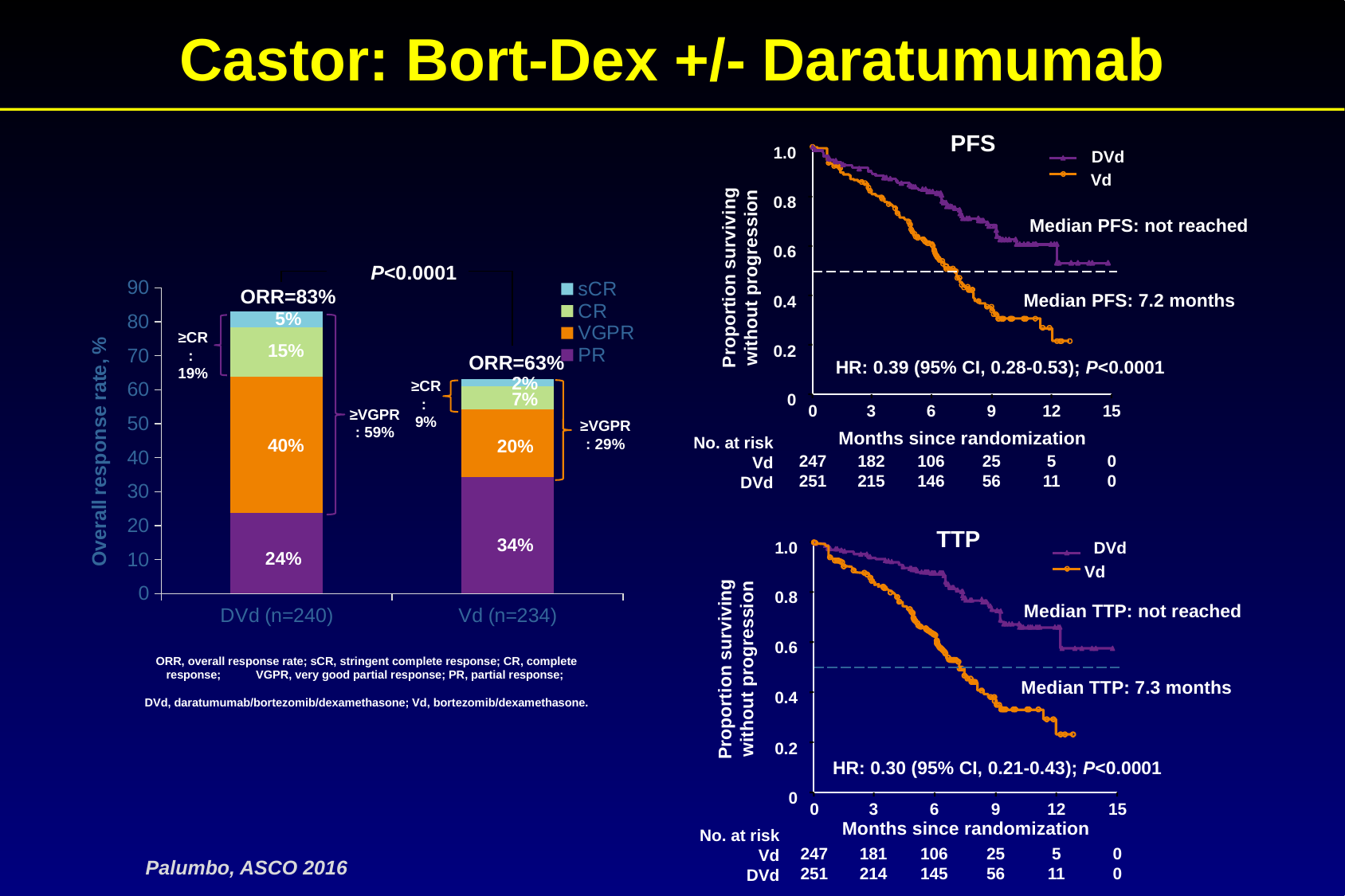
In the TTP chart, what is the median TTP for the Vd group? 7.3 months How many treatment groups are shown on the x axis of the bar chart on the left? 2 In the bar chart on the left, what is the overall response rate (ORR) for the DVd (n=240) stacked bar? 83% In the bar chart on the left, what is the sCR value for Vd (n=234)? 2% In the bar chart on the left, what is the PR value for Vd (n=234)? 34% In the bar chart on the left, what is the difference between the VGPR values for DVd and Vd? 20 percentage points In the PFS chart, what is the median PFS for the Vd group? 7.2 months How many series does the legend of the bar chart on the left list? 4 In the bar chart on the left, what is the VGPR value for DVd (n=240)? 40% In the PFS chart, is the DVd proportion surviving without progression at 12 months greater or less than 0.4? greater In the bar chart on the left, which group has the larger PR value, DVd or Vd? Vd What kind of chart is the chart on the left of the slide? Stacked bar chart